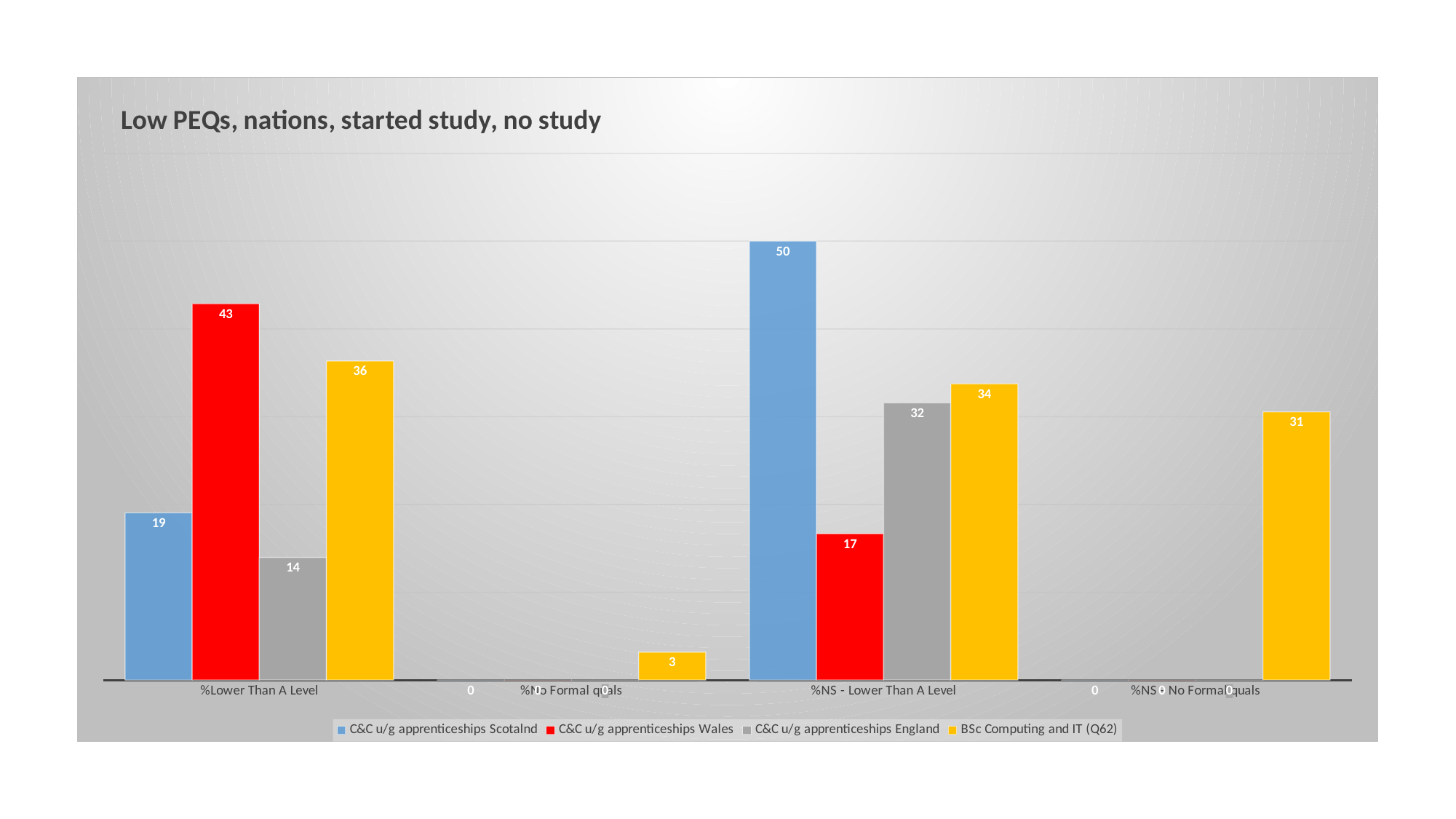
What is the value for BSc Computing and IT (Q62) in the %No Formal quals category? 3 What is the value for C&C u/g apprenticeships Scotalnd in the %NS - Lower Than A Level category? 50 What is the difference between the BSc Computing and IT (Q62) value and the C&C u/g apprenticeships England value in the %Lower Than A Level category? 22 Which is larger in the %NS - Lower Than A Level category: C&C u/g apprenticeships Scotalnd or BSc Computing and IT (Q62)? C&C u/g apprenticeships Scotalnd What is the value for C&C u/g apprenticeships Wales in the %Lower Than A Level category? 43 How many categories are shown on the x axis? 4 Which series has the lowest value in the %NS - Lower Than A Level category? C&C u/g apprenticeships Wales What is the title of the chart? Low PEQs, nations, started study, no study What kind of chart is shown on the slide? Bar chart Which series has the highest value in the %Lower Than A Level category? C&C u/g apprenticeships Wales What is the value for C&C u/g apprenticeships England in the %NS - Lower Than A Level category? 32 How many series does the legend list? 4